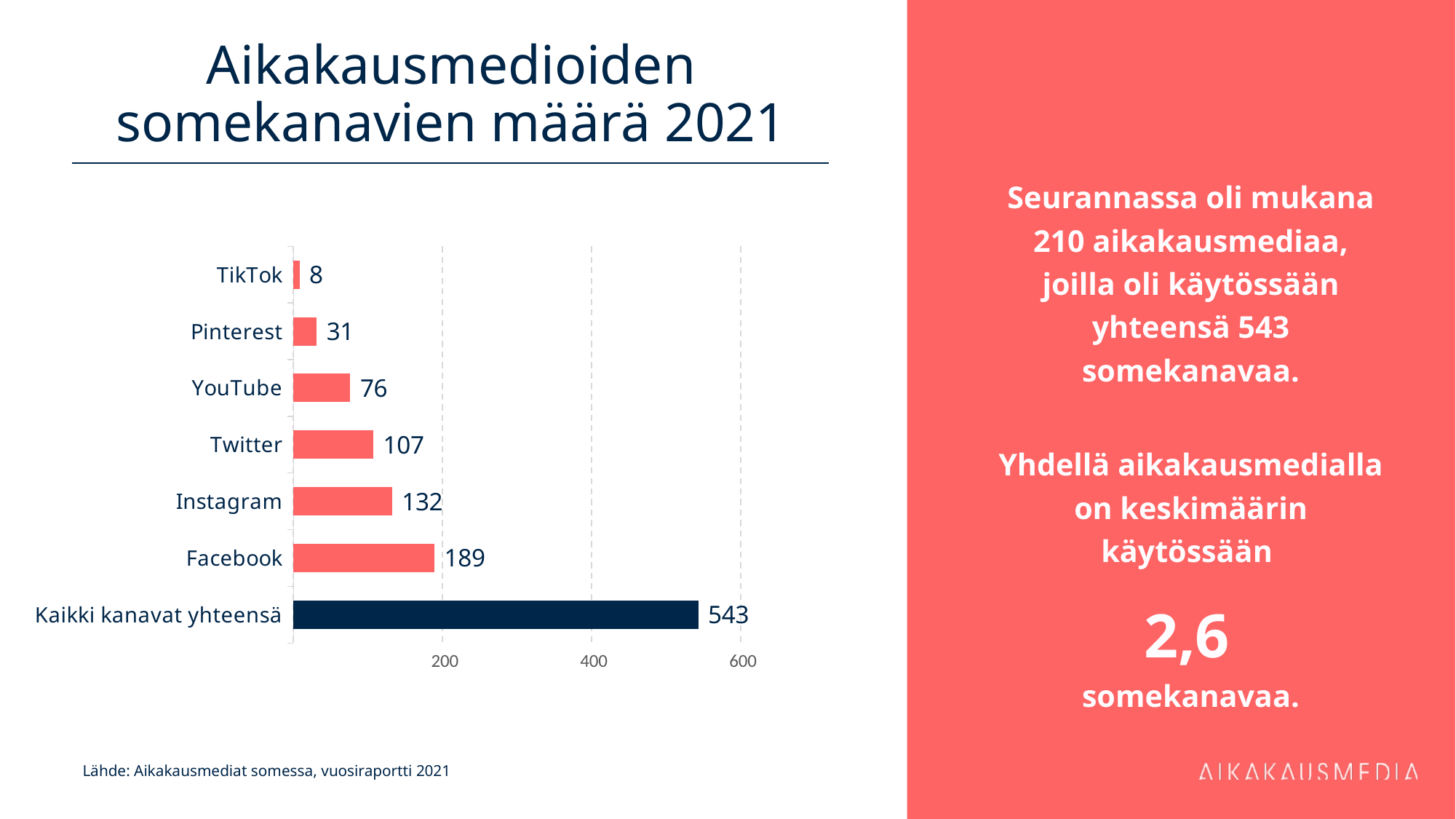
What is the difference between the values for YouTube and Pinterest? 45 What kind of chart is shown on the slide? Bar chart What is the value for Facebook? 189 Which category has the lowest value? TikTok How many categories are shown in the chart? 7 What is the value for Instagram? 132 Among the individual channels (excluding the total bar), which has the highest value? Facebook What is the value for TikTok? 8 What is the difference between the values for Facebook and Instagram? 57 Which is larger, the value for Twitter or the value for YouTube? Twitter What is the value for Kaikki kanavat yhteensä? 543 Is the value for Kaikki kanavat yhteensä greater or less than 400? greater